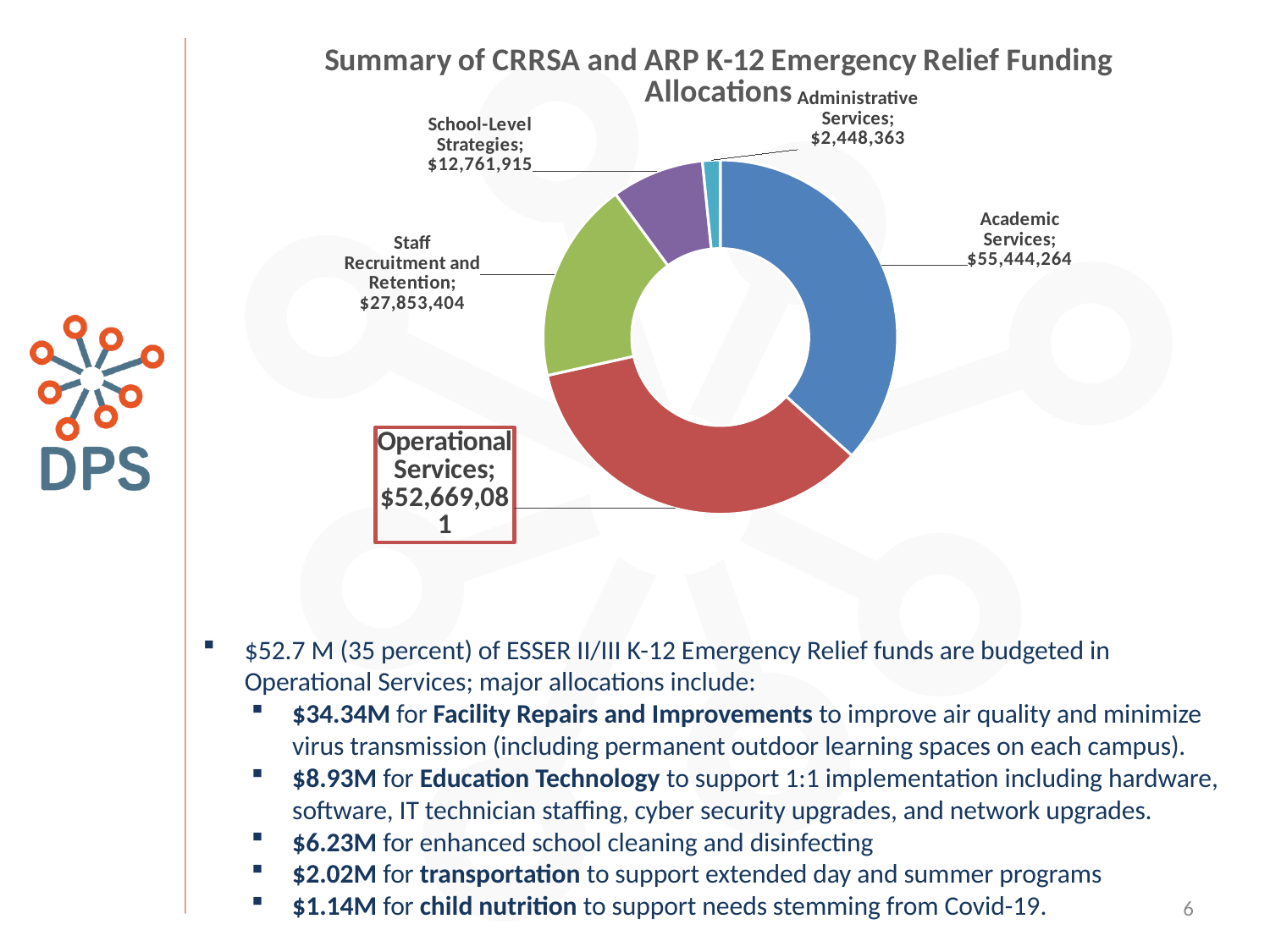
Which category has the smallest allocation in the chart? Administrative Services How many categories are shown in the chart? 5 What is the value for Operational Services in the chart? $52,669,081 What is the difference between the Staff Recruitment and Retention and School-Level Strategies allocations? $15,091,489 What is the value for Staff Recruitment and Retention in the chart? $27,853,404 What is the value for Administrative Services in the chart? $2,448,363 Which is larger, the allocation for Staff Recruitment and Retention or for School-Level Strategies? Staff Recruitment and Retention Which category has the largest allocation in the chart? Academic Services What is the difference between the Academic Services and Operational Services allocations? $2,775,183 What is the value for School-Level Strategies in the chart? $12,761,915 What is the value for Academic Services in the chart? $55,444,264 What type of chart is shown on the slide? Doughnut chart